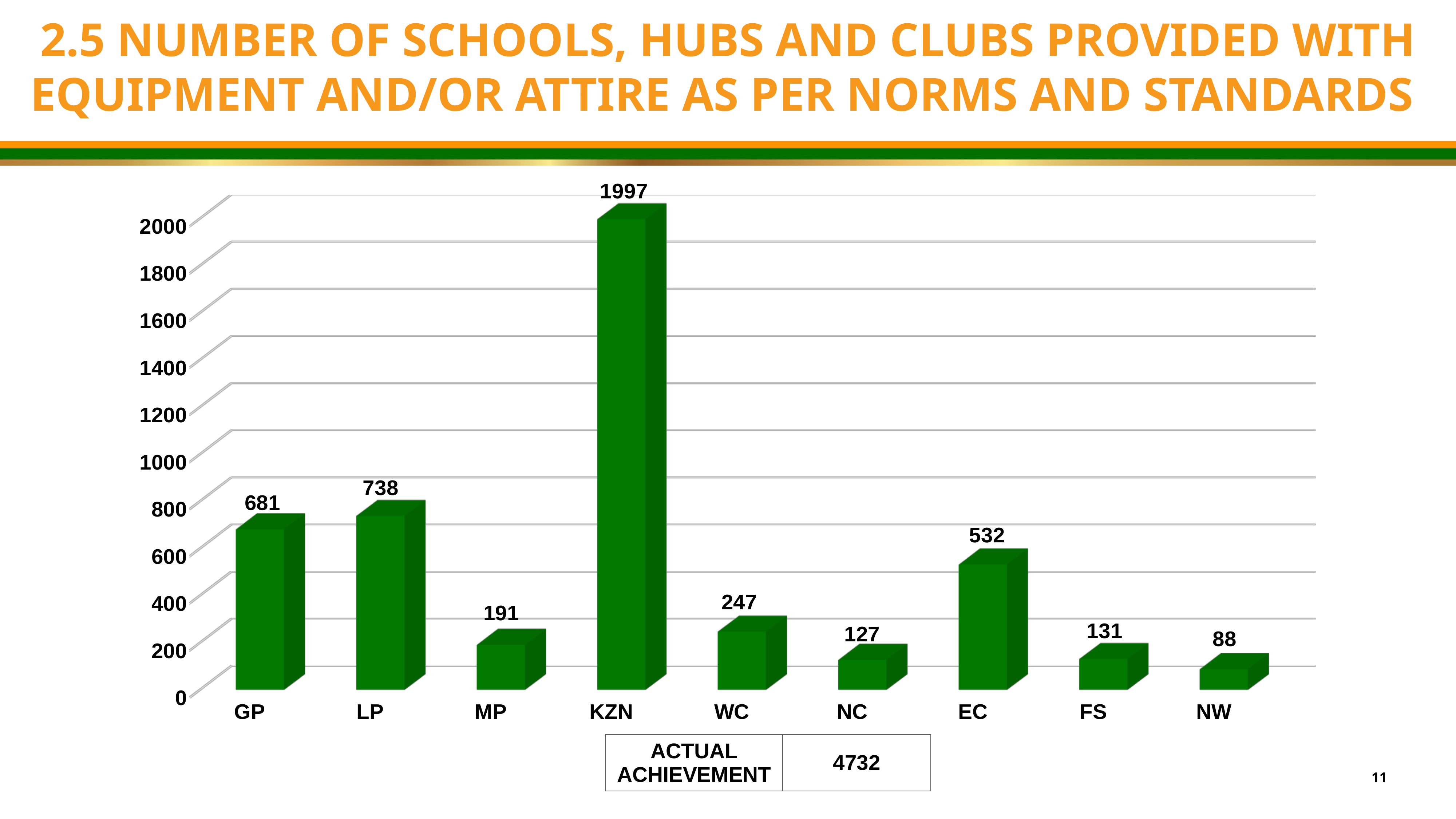
What colour are the bars in the chart? green What kind of chart is shown on the slide? bar chart What is the actual achievement total shown below the chart? 4732 Is the value for EC greater or less than 400? greater Which province has the lowest value? NW Which province has the highest value? KZN What is the value for KZN? 1997 Which is larger, the value for WC or the value for MP? WC What is the value for NW? 88 What is the difference between the values for LP and GP? 57 How many provinces are shown on the x axis? 9 What is the value for EC? 532